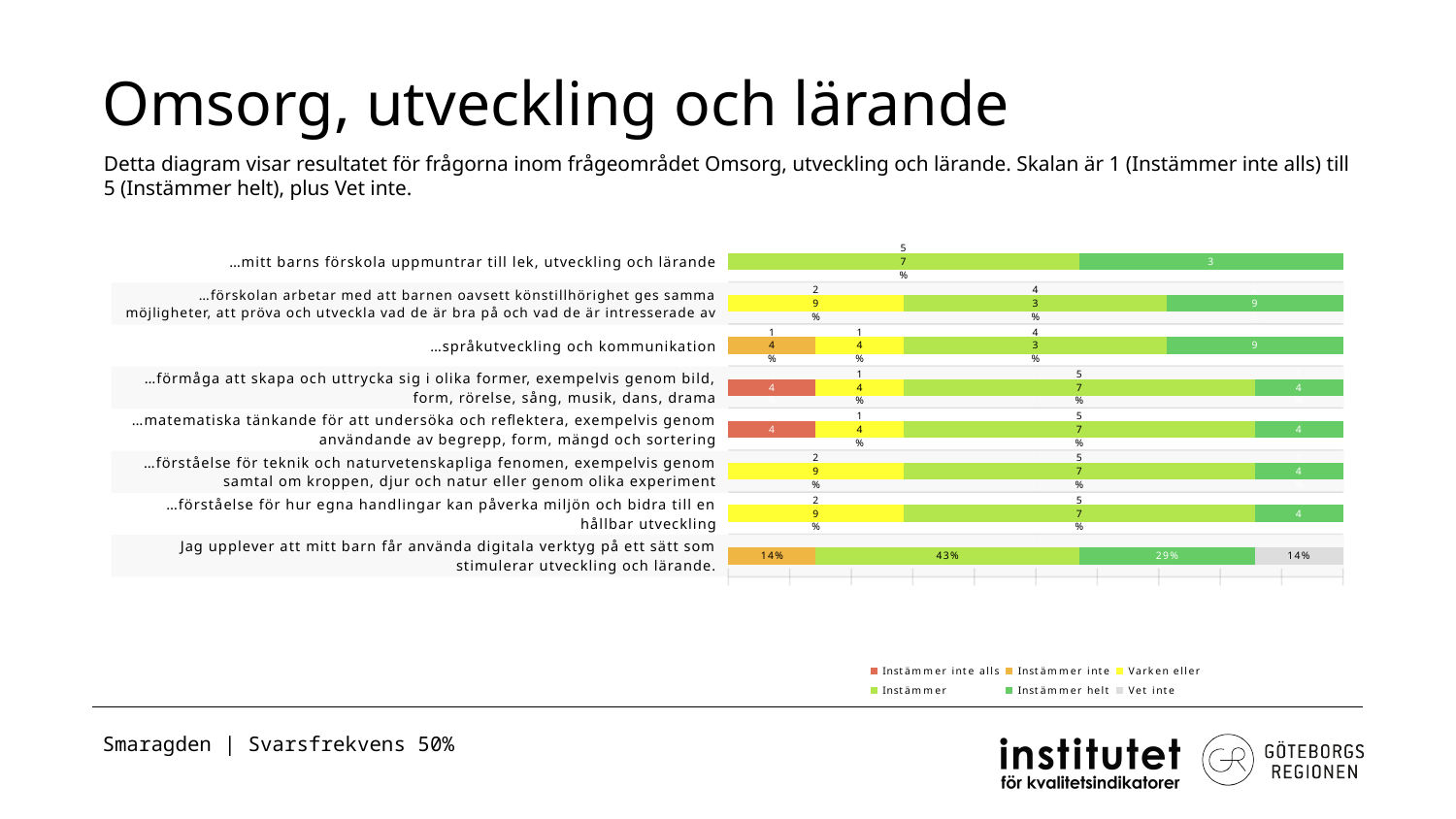
What colour does the legend use for Vet inte? Grey What kind of chart is shown on the slide? Stacked horizontal bar chart For the statement about digitala verktyg, what share answered Vet inte? 14% How many statements (bars) are plotted in the chart? 8 For the statement "Jag upplever att mitt barn får använda digitala verktyg på ett sätt som stimulerar utveckling och lärande", what share answered Instämmer? 43% For the statement about digitala verktyg, what share answered Instämmer helt? 29% For the statement about digitala verktyg, what is the difference between the Instämmer share and the Instämmer helt share? 14 percentage points For the statement about digitala verktyg, which response category has the largest share? Instämmer For the statement about digitala verktyg, what do the four printed shares add up to? 100% How many response categories does the legend list? 6 For the statement "...mitt barns förskola uppmuntrar till lek, utveckling och lärande", which segment is larger: Instämmer or Instämmer helt? Instämmer For the statement about digitala verktyg, which is larger: the Instämmer share or the Instämmer helt share? Instämmer